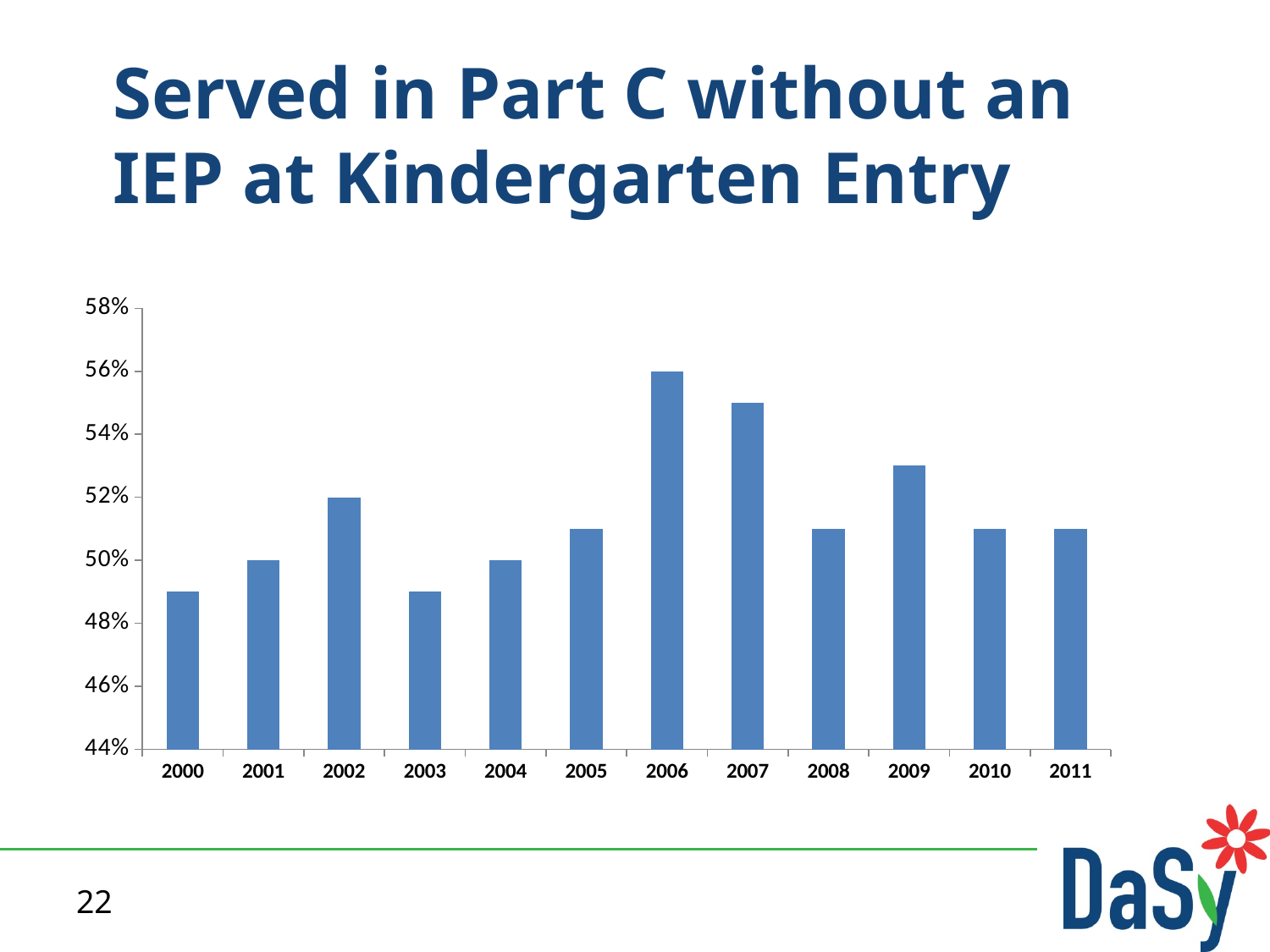
What is the difference between the values for 2006 and 2002? 4 percentage points How many years are shown on the x axis of the chart? 12 Is the value for 2009 greater or less than 52%? greater Do the values rise or fall from 2006 to 2008? fall Which is larger, the value for 2002 or the value for 2003? 2002 Which year has the highest value in the chart? 2006 What is the value for 2006? 56% What is the value for 2001? 50% What type of chart is shown on the slide? bar chart What is the value for 2002? 52% Is the value for 2000 greater or less than 50%? less Is the value for 2007 greater or less than 54%? greater